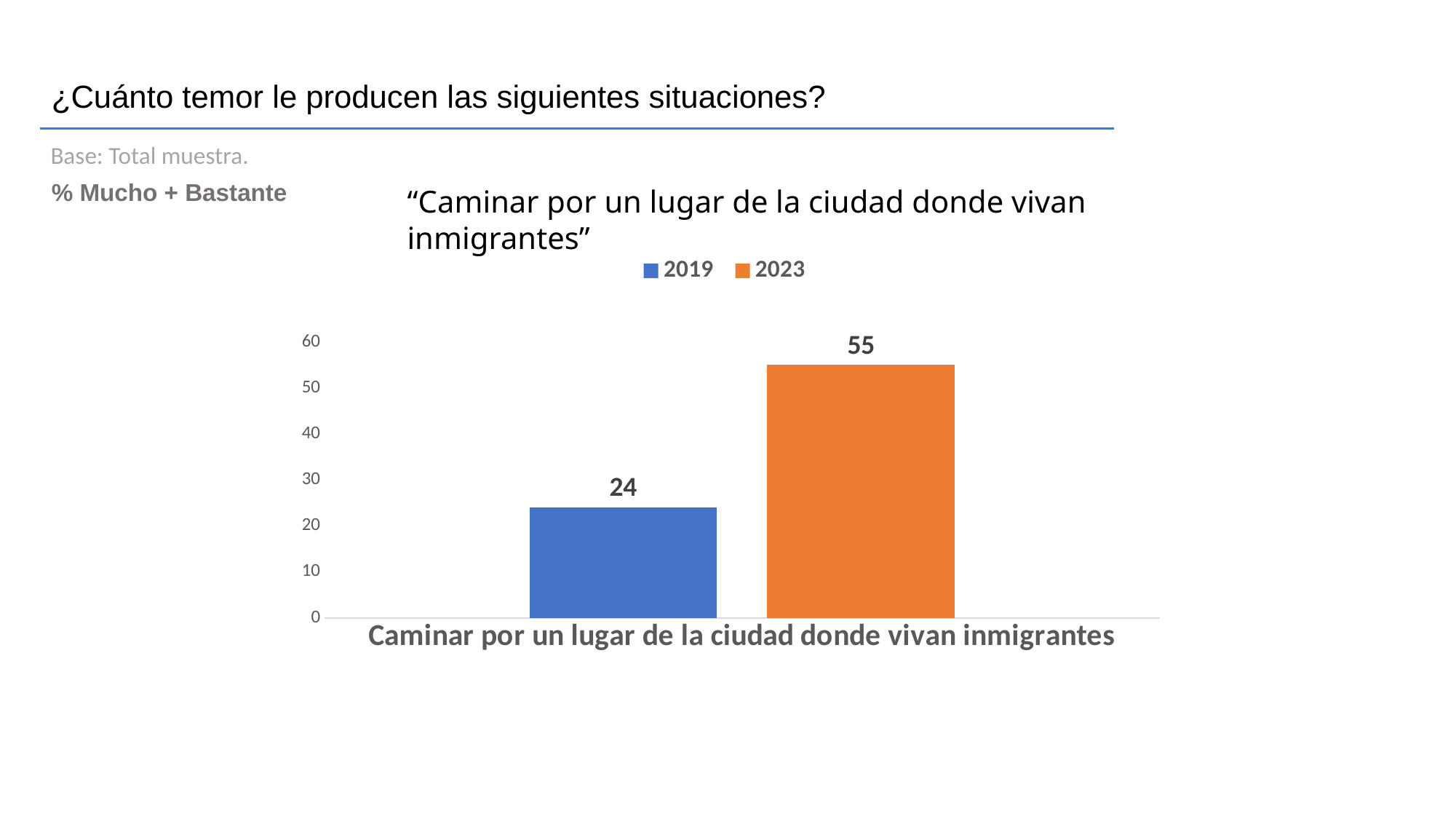
Which year has the higher value, 2019 or 2023? 2023 What is the value for 2019 in the chart? 24 Which series has the highest value in the chart? 2023 Is the value for 2019 greater or less than 30? less Which series has the lowest value in the chart? 2019 What is the difference between the 2023 value and the 2019 value? 31 Did the value rise or fall from 2019 to 2023? Rise What is the value for 2023 in the chart? 55 How many series does the legend list? 2 What colour is the bar for 2023? Orange Is the value for 2023 greater or less than 50? greater What kind of chart is shown on the slide? Bar chart